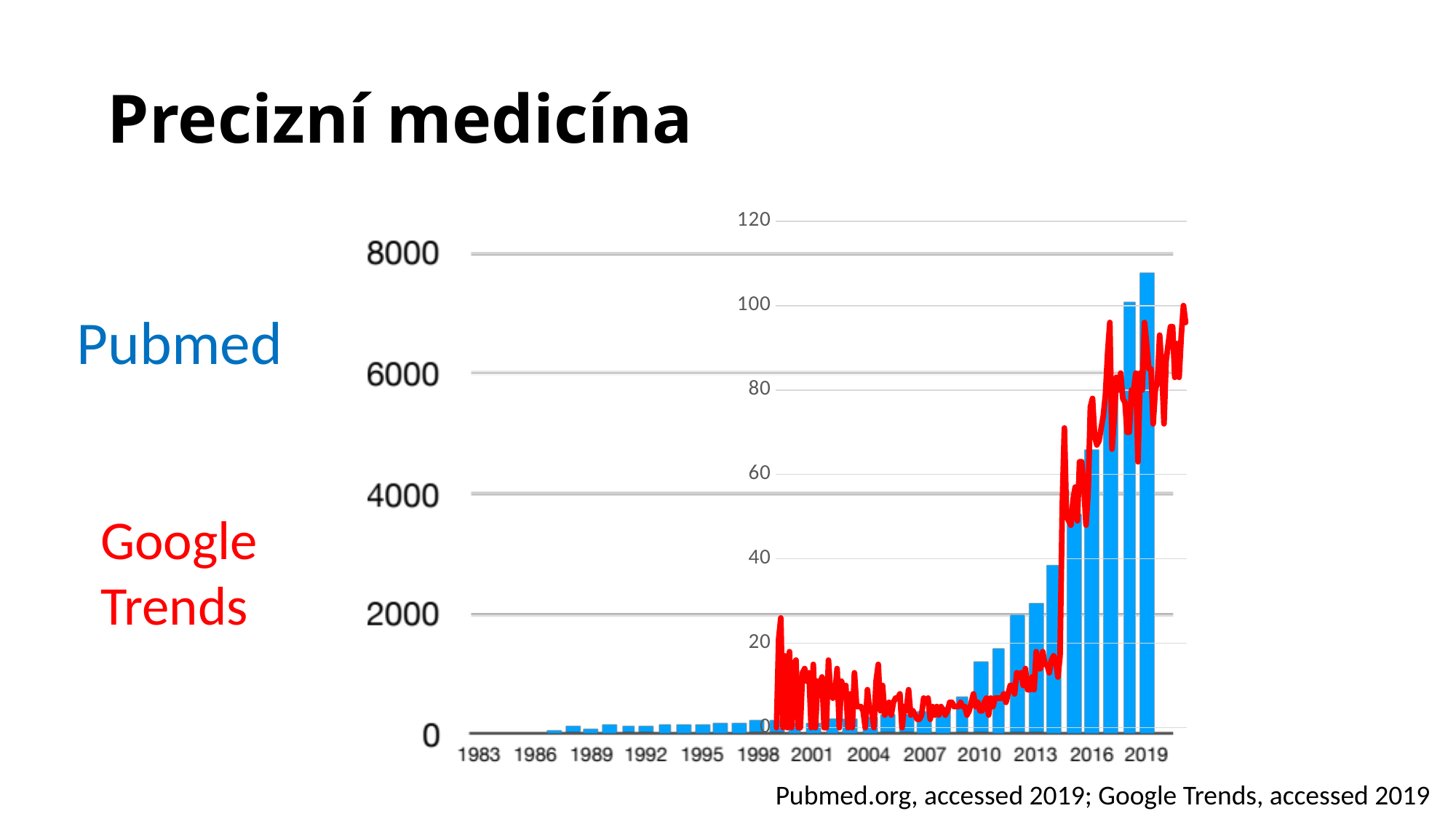
Is the Pubmed value for 2016 greater or less than 4000? greater What kind of chart is used to show the Pubmed data on the slide? bar chart What colour is the Google Trends line? red What kind of chart is used to show the Google Trends data on the slide? line chart Which is larger, the Pubmed value for 2019 or for 2010? 2019 Is the Pubmed value for 2013 greater or less than 4000? less Is the Pubmed value for 2007 greater or less than 2000? less Do the Pubmed values generally rise or fall from 1983 to 2019? rise How many year labels are shown on the x axis? 13 Which is larger, the Google Trends value around 2016 or around 2004? 2016 Which year has the highest Pubmed bar? 2019